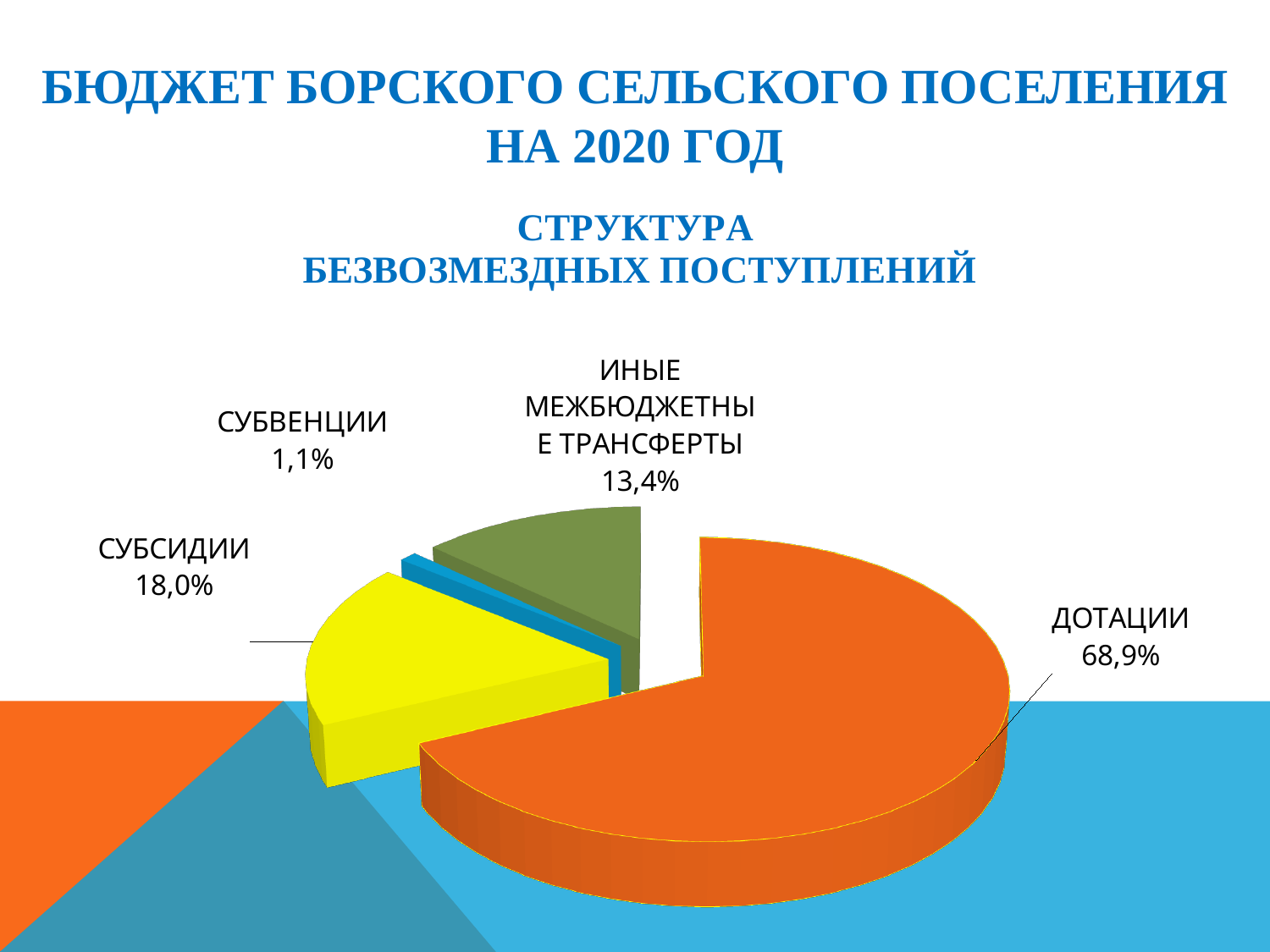
How many categories are shown in the pie chart? 4 Which category has the smallest share of the pie? СУБВЕНЦИИ What share of the pie does ДОТАЦИИ have? 68,9% What share of the pie does СУБВЕНЦИИ have? 1,1% What is the difference in percentage points between ДОТАЦИИ and СУБСИДИИ? 50,9 Which category has the largest share of the pie? ДОТАЦИИ What kind of chart is shown on the slide? Pie chart What share of the pie does СУБСИДИИ have? 18,0% Which is larger, the share for СУБСИДИИ or the share for ИНЫЕ МЕЖБЮДЖЕТНЫЕ ТРАНСФЕРТЫ? СУБСИДИИ What colour is the ДОТАЦИИ slice? Orange What is the difference in percentage points between СУБСИДИИ and ИНЫЕ МЕЖБЮДЖЕТНЫЕ ТРАНСФЕРТЫ? 4,6